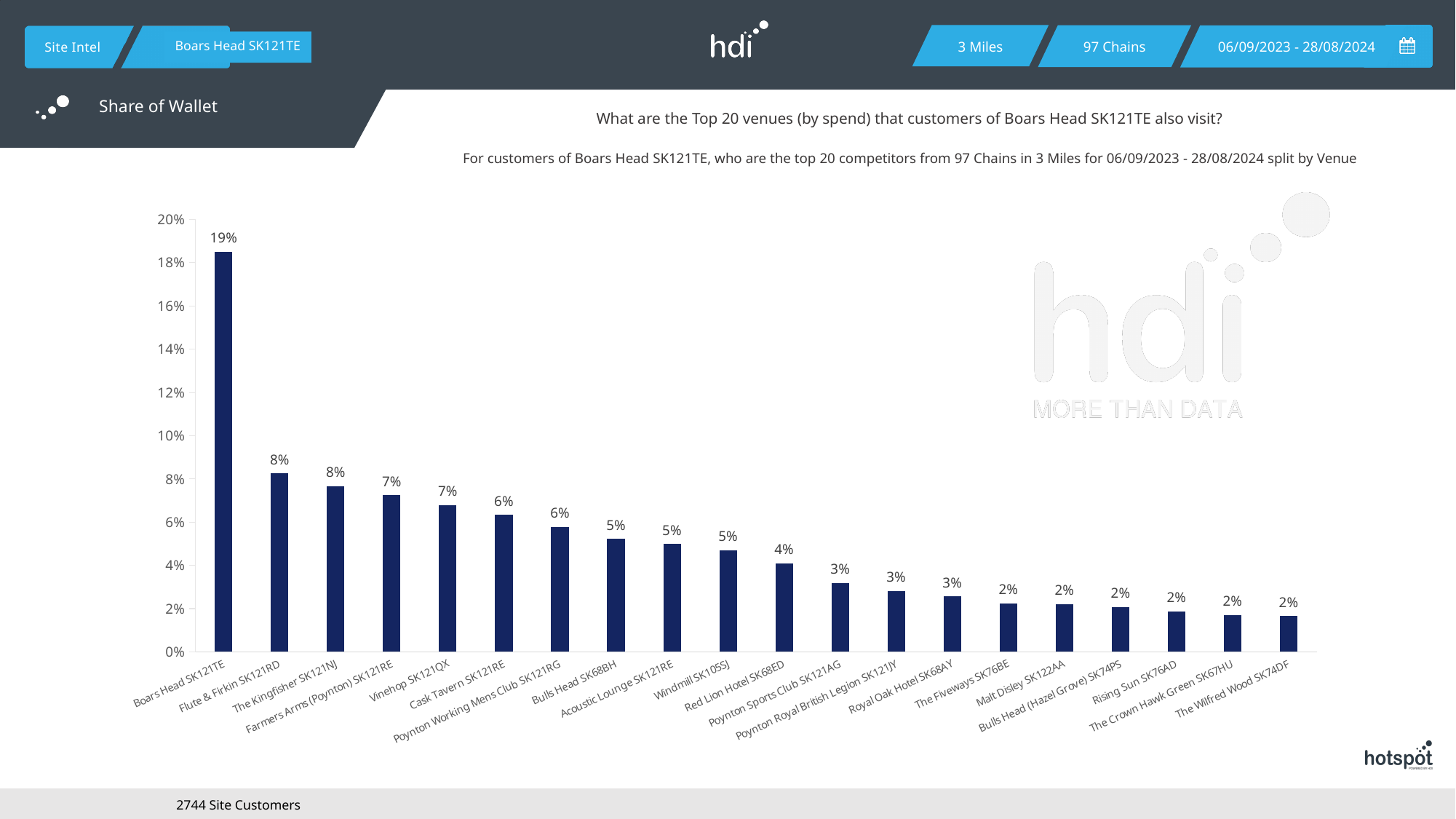
Which venue has the highest value? Boars Head SK121TE Which is larger, the value for Red Lion Hotel SK68ED or Poynton Sports Club SK121AG? Red Lion Hotel SK68ED What is the value for Poynton Sports Club SK121AG? 3% What is the difference between the values for Boars Head SK121TE and Flute & Firkin SK121RD? 11% What is the value for Boars Head SK121TE? 19% How many site customers are stated at the bottom of the slide? 2744 What kind of chart is shown on the slide? bar chart How many venues are shown on the chart? 20 Do the values rise or fall from left to right along the x axis? fall What is the value for Vinehop SK121QX? 7% Is the value for Boars Head SK121TE greater or less than 18%? greater What is the value for Red Lion Hotel SK68ED? 4%